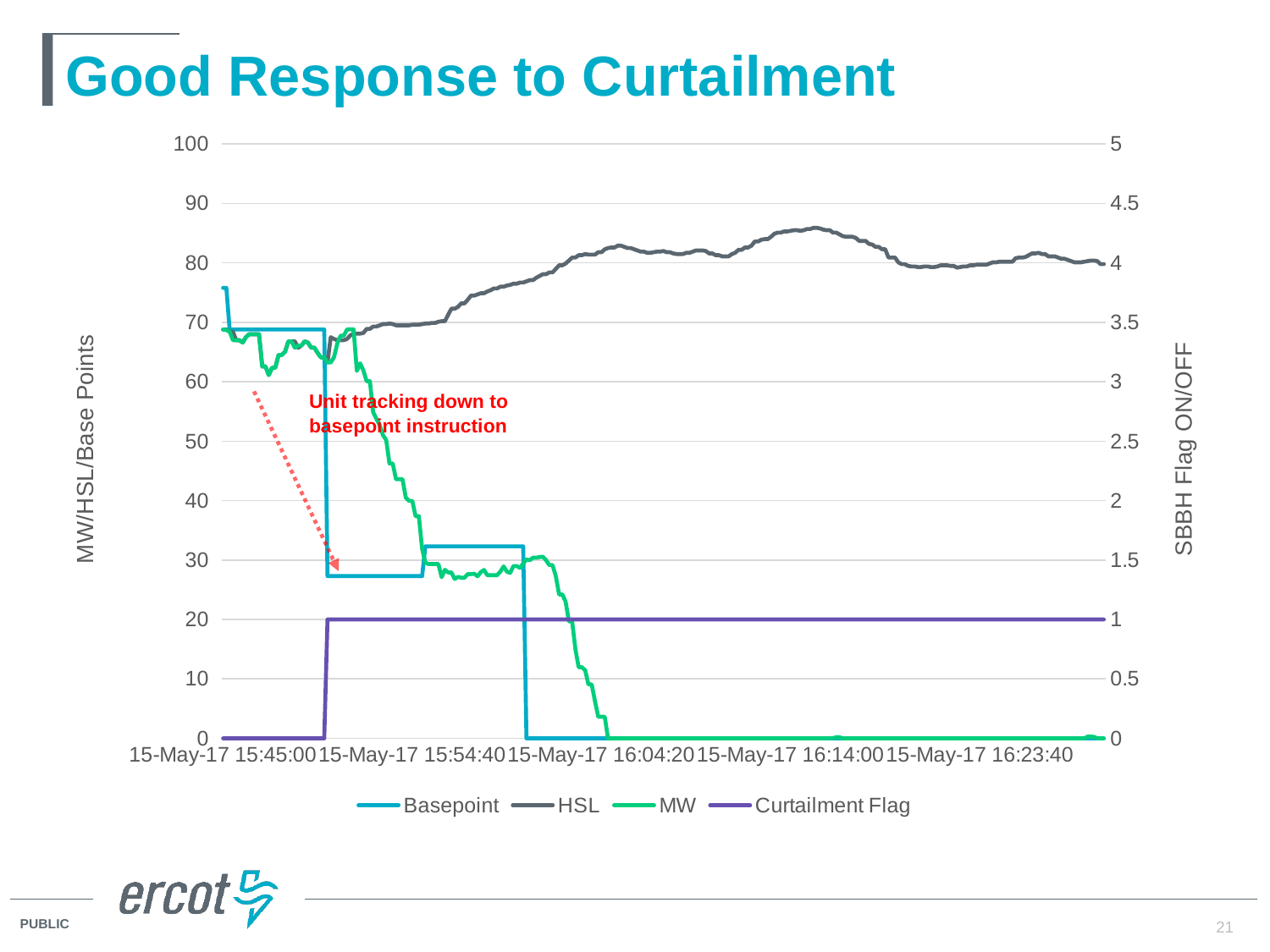
Is the HSL value at 15-May-17 16:14:00 greater or less than 80? greater Does the MW series rise or fall overall from left to right? fall What is the value of the Curtailment Flag at 15-May-17 15:45:00 on the right axis? 0 Which series has the highest value at 15-May-17 16:23:40? HSL What is the value of the Curtailment Flag at 15-May-17 16:14:00 on the right axis? 1 What is the Basepoint value at 15-May-17 16:14:00? 0 What kind of chart is shown on the slide? line chart What is the label of the right-hand vertical axis? SBBH Flag ON/OFF Is the MW value at 15-May-17 16:23:40 greater or less than 10? less At 15-May-17 16:14:00, which is larger, HSL or MW? HSL How many series does the legend list? 4 Is the HSL value at 15-May-17 15:45:00 greater or less than 80? less